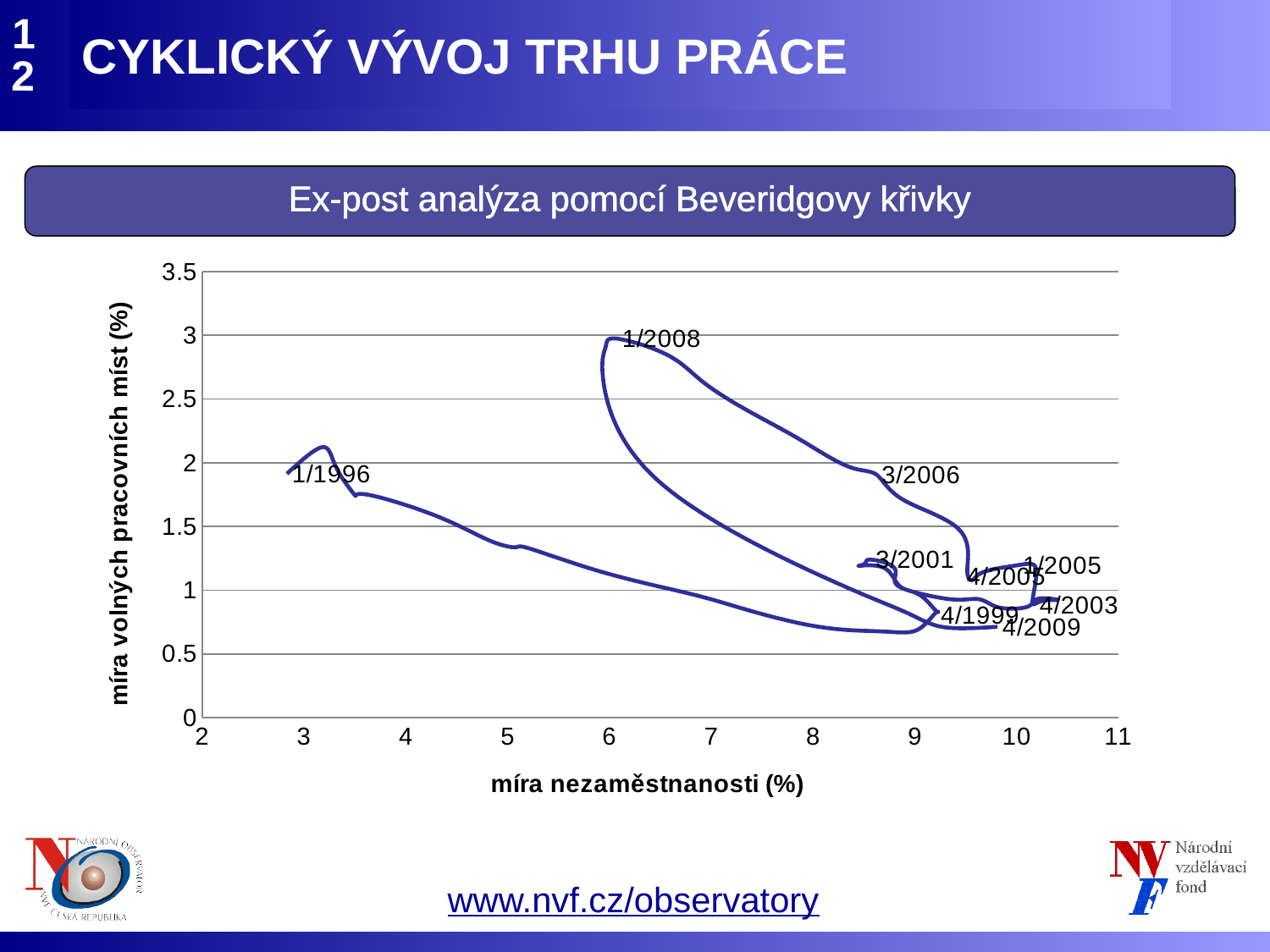
Is the unemployment rate at 3/2006 greater or less than 8? greater Is the vacancy rate at 4/2009 greater or less than 1? less Which labeled point has the lowest unemployment rate (míra nezaměstnanosti)? 1/1996 How many labeled time points are marked on the curve? 9 Is the vacancy rate at 1/2008 greater or less than 2.5? greater What kind of chart is shown on the slide? line chart What is the label of the horizontal axis? míra nezaměstnanosti (%) Which has the higher vacancy rate, 1/2008 or 3/2006? 1/2008 Which has the higher unemployment rate, 1/1996 or 4/2009? 4/2009 Which labeled point has the highest vacancy rate (míra volných pracovních míst)? 1/2008 What is the title of the chart? Ex-post analýza pomocí Beveridgovy křivky